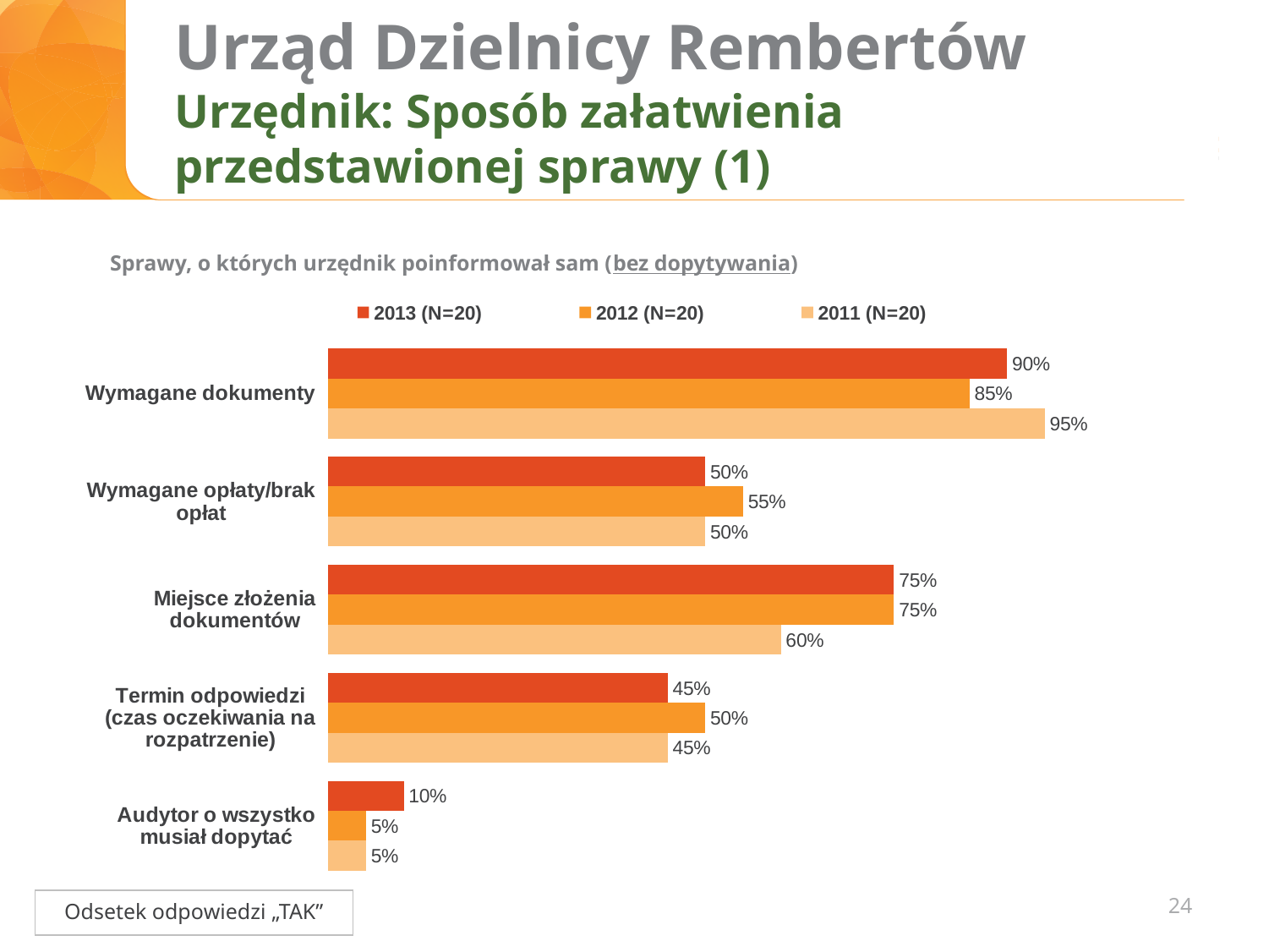
What kind of chart is shown on the slide? Bar chart What is the difference between the 2013 (N=20) and 2012 (N=20) values for "Audytor o wszystko musiał dopytać"? 5% How many categories are shown on the chart? 5 What is the value for "Wymagane dokumenty" in the 2013 (N=20) series? 90% How many series does the legend list? 3 Which category has the lowest value in the 2013 (N=20) series? Audytor o wszystko musiał dopytać Which category has the highest value in the 2011 (N=20) series? Wymagane dokumenty What is the value for "Audytor o wszystko musiał dopytać" in the 2012 (N=20) series? 5% Which is larger for "Termin odpowiedzi (czas oczekiwania na rozpatrzenie)": the 2012 (N=20) value or the 2013 (N=20) value? 2012 (N=20) What is the subtitle printed above the chart? Sprawy, o których urzędnik poinformował sam (bez dopytywania) What is the value for "Miejsce złożenia dokumentów" in the 2011 (N=20) series? 60% What is the difference between the 2011 (N=20) and 2012 (N=20) values for "Wymagane dokumenty"? 10%